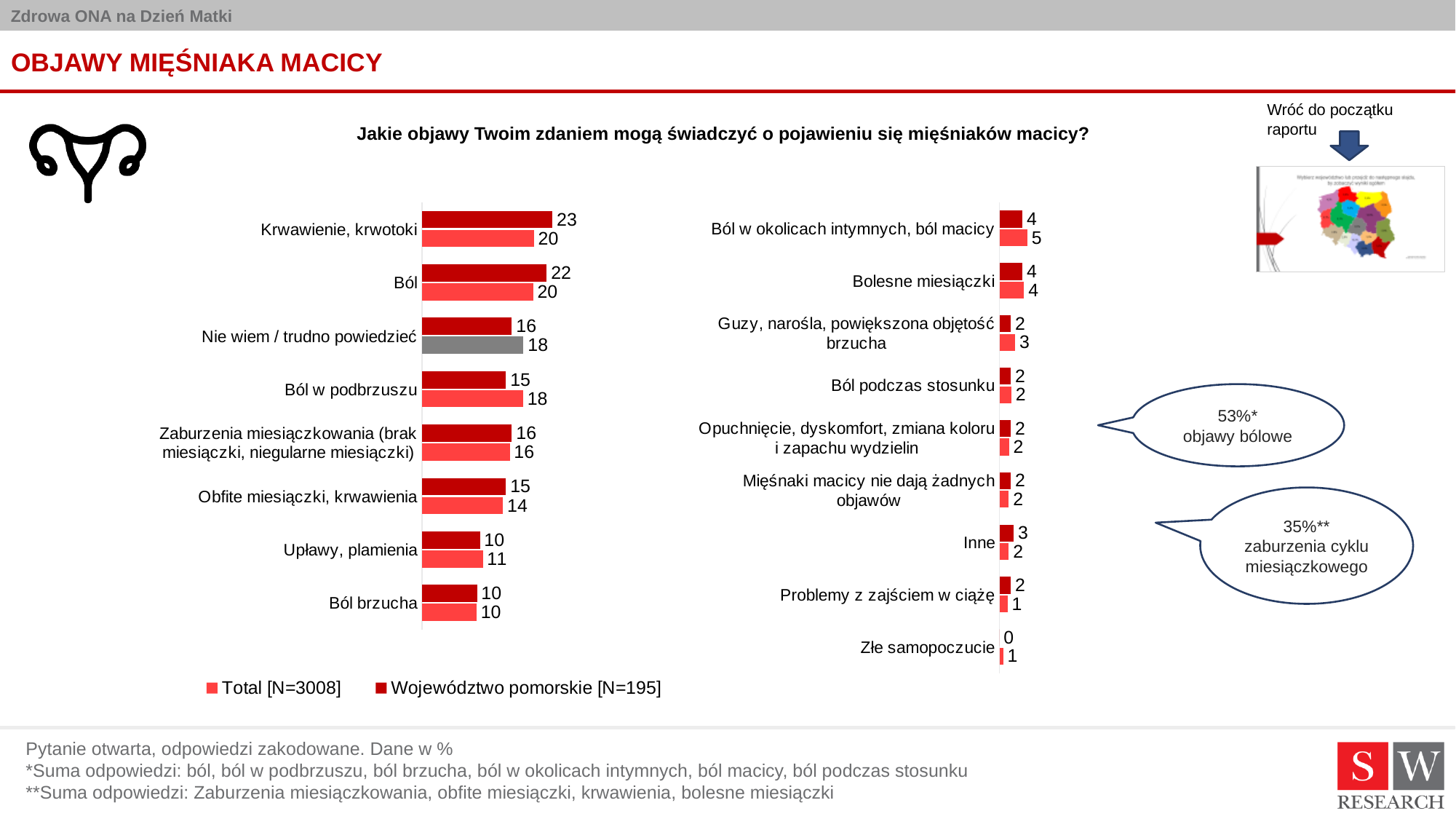
In the right chart, what is the value for Total [N=3008] for Ból w okolicach intymnych, ból macicy? 5 In the right chart, what is the value for Województwo pomorskie [N=195] for Inne? 3 How many categories are shown in the left chart? 8 In the left chart, what is the value for Total [N=3008] for Krwawienie, krwotoki? 20 In the left chart, what is the value for Województwo pomorskie [N=195] for Ból? 22 How many categories are shown in the right chart? 9 In the left chart, which is larger for Upławy, plamienia: the Total [N=3008] value or the Województwo pomorskie [N=195] value? Total [N=3008] In the left chart, which category has the highest value for Województwo pomorskie [N=195]? Krwawienie, krwotoki In the left chart, what is the difference between the Województwo pomorskie [N=195] and Total [N=3008] values for Ból w podbrzuszu? 3 What type of chart is used on this slide? Bar chart In the right chart, which category has the lowest value for Województwo pomorskie [N=195]? Złe samopoczucie How many series does the legend list? 2